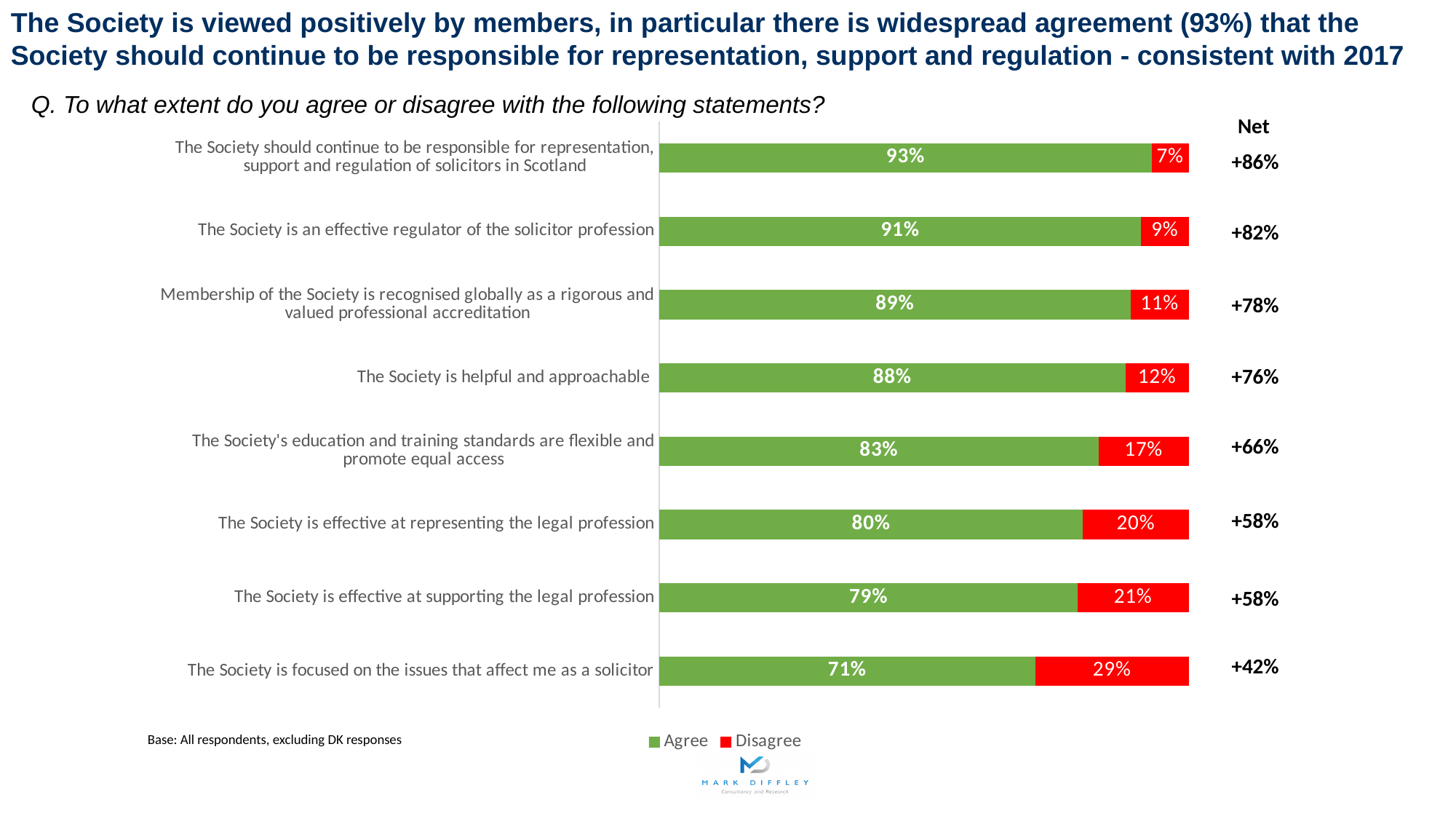
What is the Agree value for 'The Society is helpful and approachable'? 88% What kind of chart is shown on the slide? Stacked bar chart Which statement has the lowest Agree percentage? The Society is focused on the issues that affect me as a solicitor What percentage of respondents agree that the Society is an effective regulator of the solicitor profession? 91% How many statements are shown in the chart? 8 Which colour represents Disagree in the chart? Red How many series does the legend list? 2 What is the difference between the Agree and Disagree percentages for 'The Society is effective at representing the legal profession'? 60% Which has a higher Disagree percentage: 'The Society is effective at supporting the legal profession' or 'The Society's education and training standards are flexible and promote equal access'? The Society is effective at supporting the legal profession Which statement has the highest Agree percentage? The Society should continue to be responsible for representation, support and regulation of solicitors in Scotland What is the Net score shown for 'Membership of the Society is recognised globally as a rigorous and valued professional accreditation'? +78% What percentage of respondents disagree that the Society is focused on the issues that affect me as a solicitor? 29%